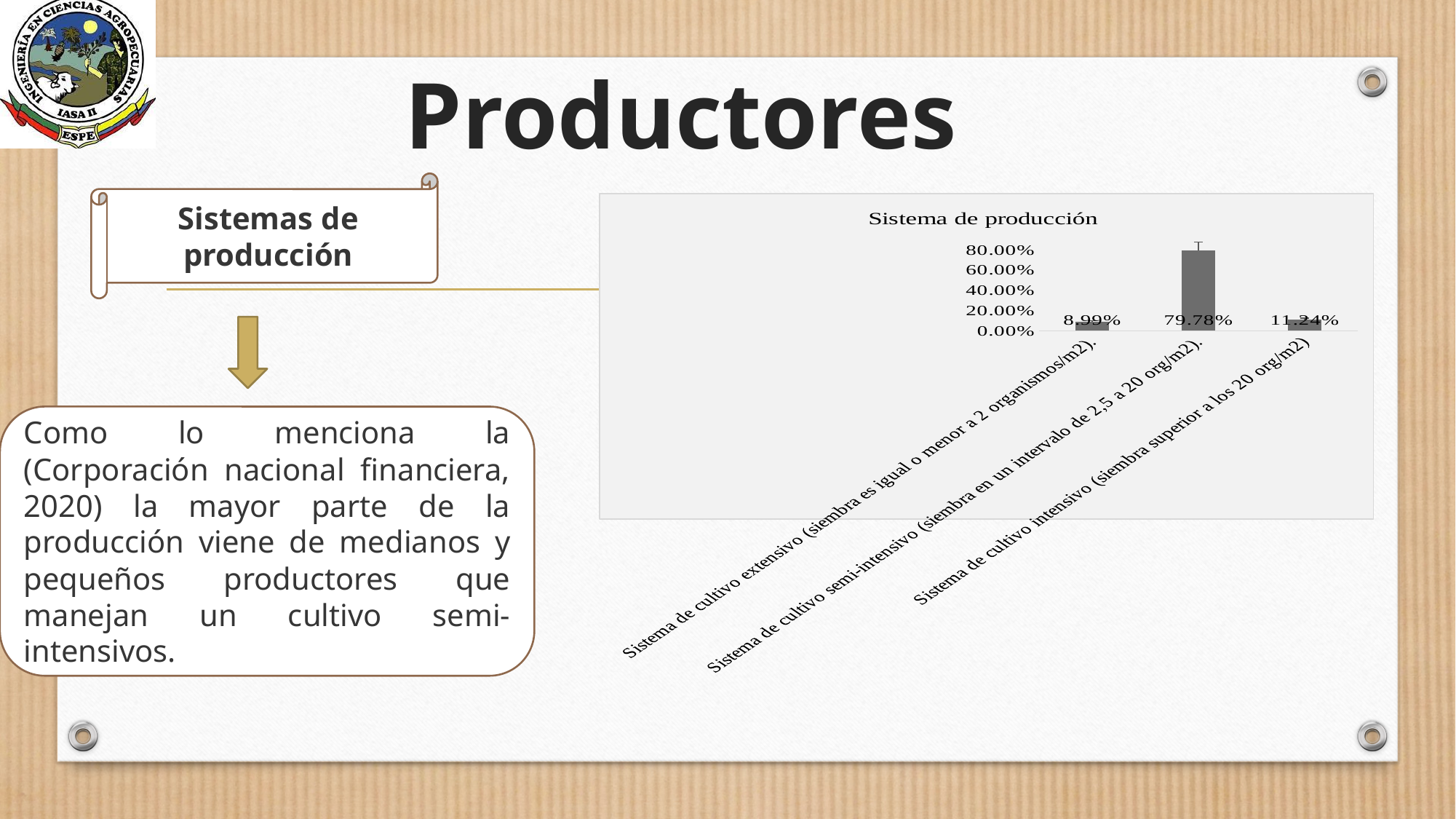
What is the difference between the values for Sistema de cultivo semi-intensivo and Sistema de cultivo intensivo? 68.54% What is the difference between the values for Sistema de cultivo intensivo and Sistema de cultivo extensivo? 2.25% What is the value for Sistema de cultivo extensivo in the chart? 8.99% Which is larger, the value for Sistema de cultivo intensivo or Sistema de cultivo extensivo? Sistema de cultivo intensivo What kind of chart is shown on the slide? Bar chart Is the value for Sistema de cultivo semi-intensivo greater or less than 60.00%? greater Which production system has the lowest value in the chart? Sistema de cultivo extensivo What is the value for Sistema de cultivo intensivo in the chart? 11.24% How many production systems are shown in the chart? 3 Which production system has the highest value in the chart? Sistema de cultivo semi-intensivo What is the title of the chart on the slide? Sistema de producción What is the value for Sistema de cultivo semi-intensivo in the chart? 79.78%